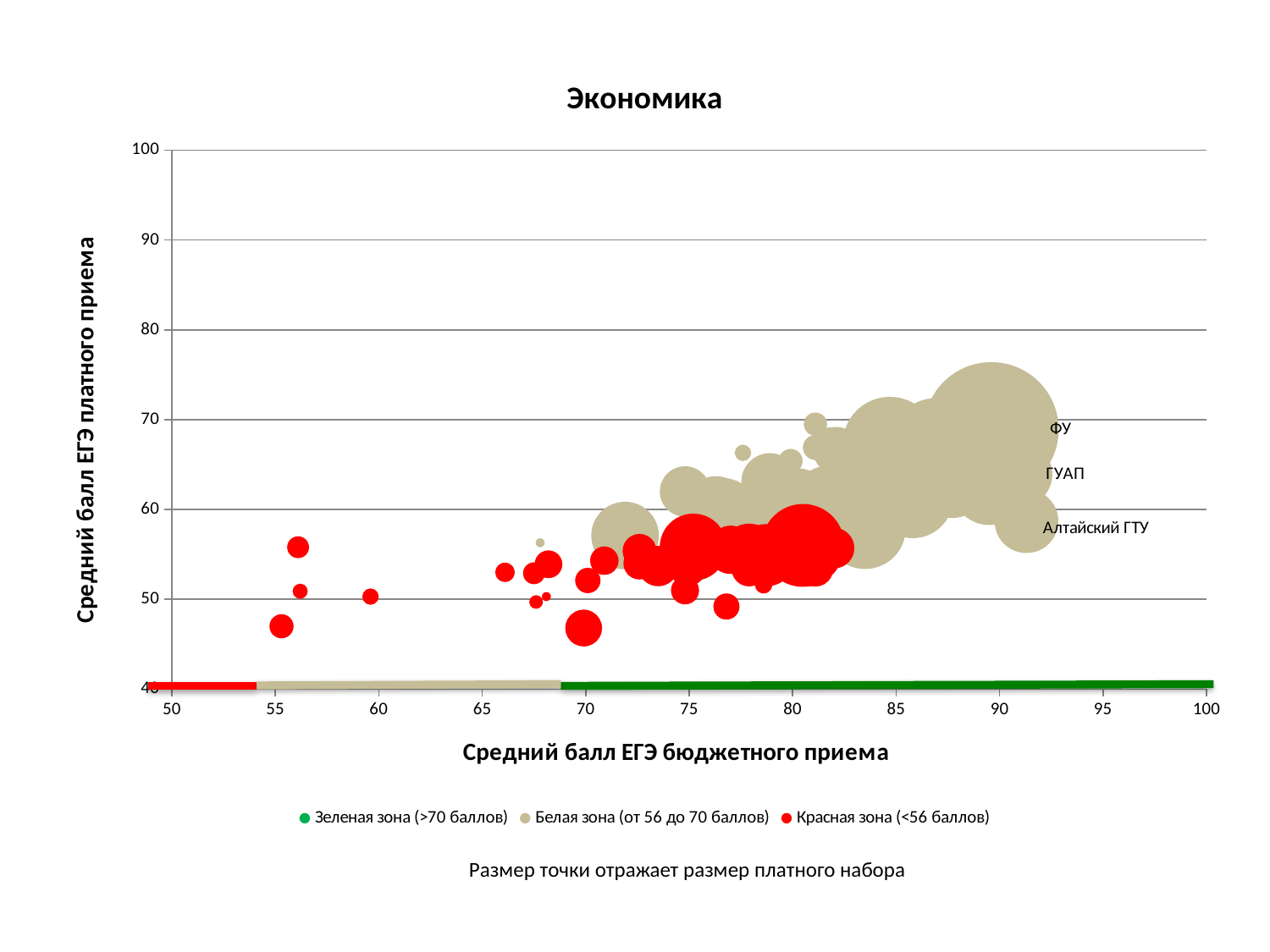
What is the title of the chart? Экономика Which legend series corresponds to the red bubbles? Красная зона (<56 баллов) Do the y values generally rise or fall as the x values increase? rise What is the label of the x axis? Средний балл ЕГЭ бюджетного приема Is the x value for the point labelled ФУ greater or less than 80? greater What kind of chart is shown on the slide? bubble chart Is the x value for the point labelled Алтайский ГТУ greater or less than 70? greater How many series does the legend list? 3 Is the y value for the point labelled ФУ greater or less than 50? greater Which series has the largest bubble on the chart, the red zone or the white zone? Белая зона (от 56 до 70 баллов)